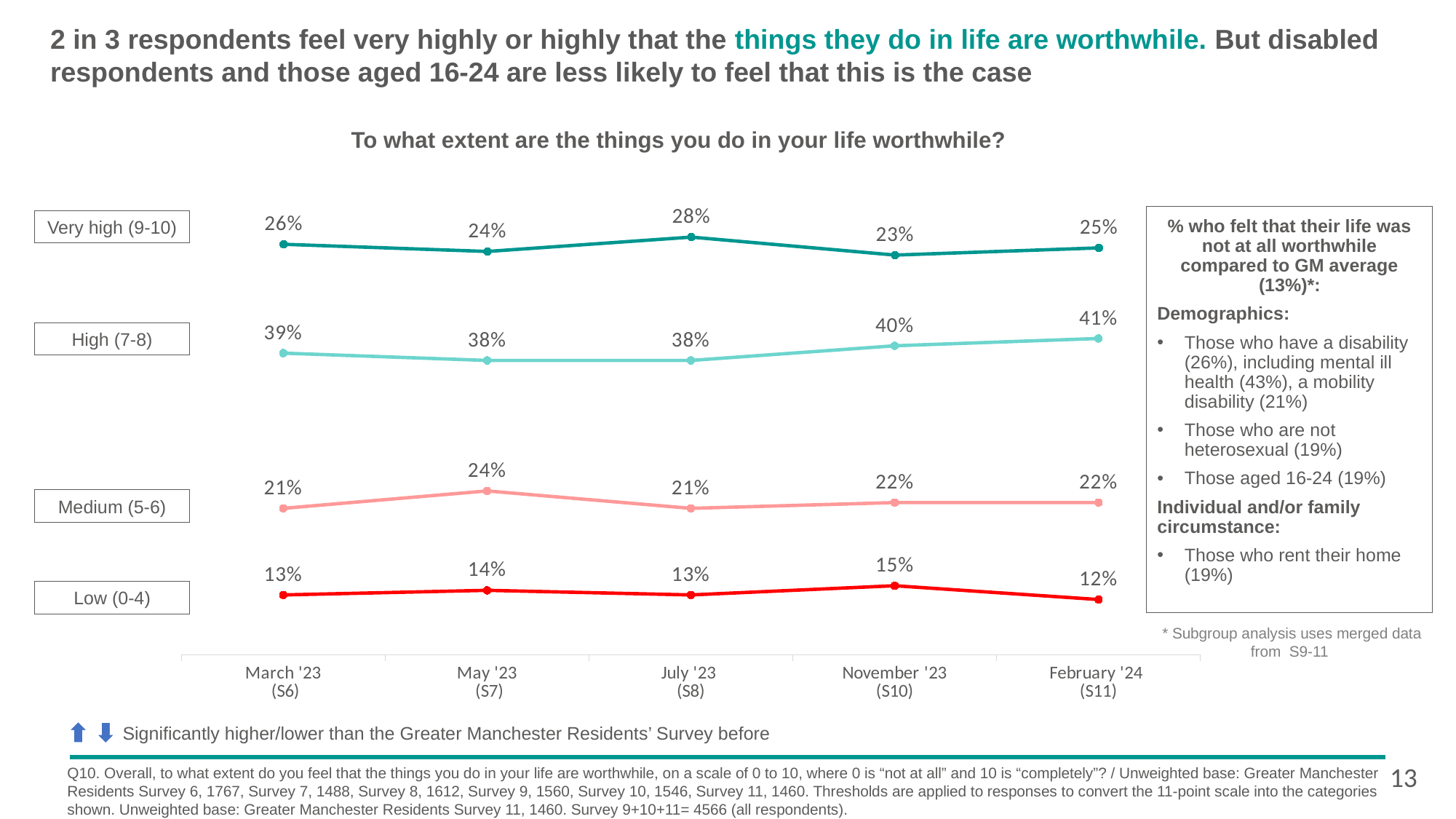
In which survey wave was the Very high (9-10) value highest? July '23 (S8) What is the title of the chart? To what extent are the things you do in your life worthwhile? What was the Low (0-4) value in May '23 (S7)? 14% How many response categories (lines) are plotted on the chart? 4 Did the High (7-8) value rise or fall between July '23 (S8) and February '24 (S11)? Rise What is the difference between the High (7-8) value in February '24 (S11) and in March '23 (S6)? 2 percentage points What was the High (7-8) value in November '23 (S10)? 40% How many survey waves are shown on the x axis? 5 What percentage of respondents rated the things they do in life as Very high (9-10) in February '24 (S11)? 25% In which survey wave was the Low (0-4) value lowest? February '24 (S11) What type of chart is used to show the responses over time? Line chart Which is larger: the Medium (5-6) value in May '23 (S7) or in July '23 (S8)? May '23 (S7)